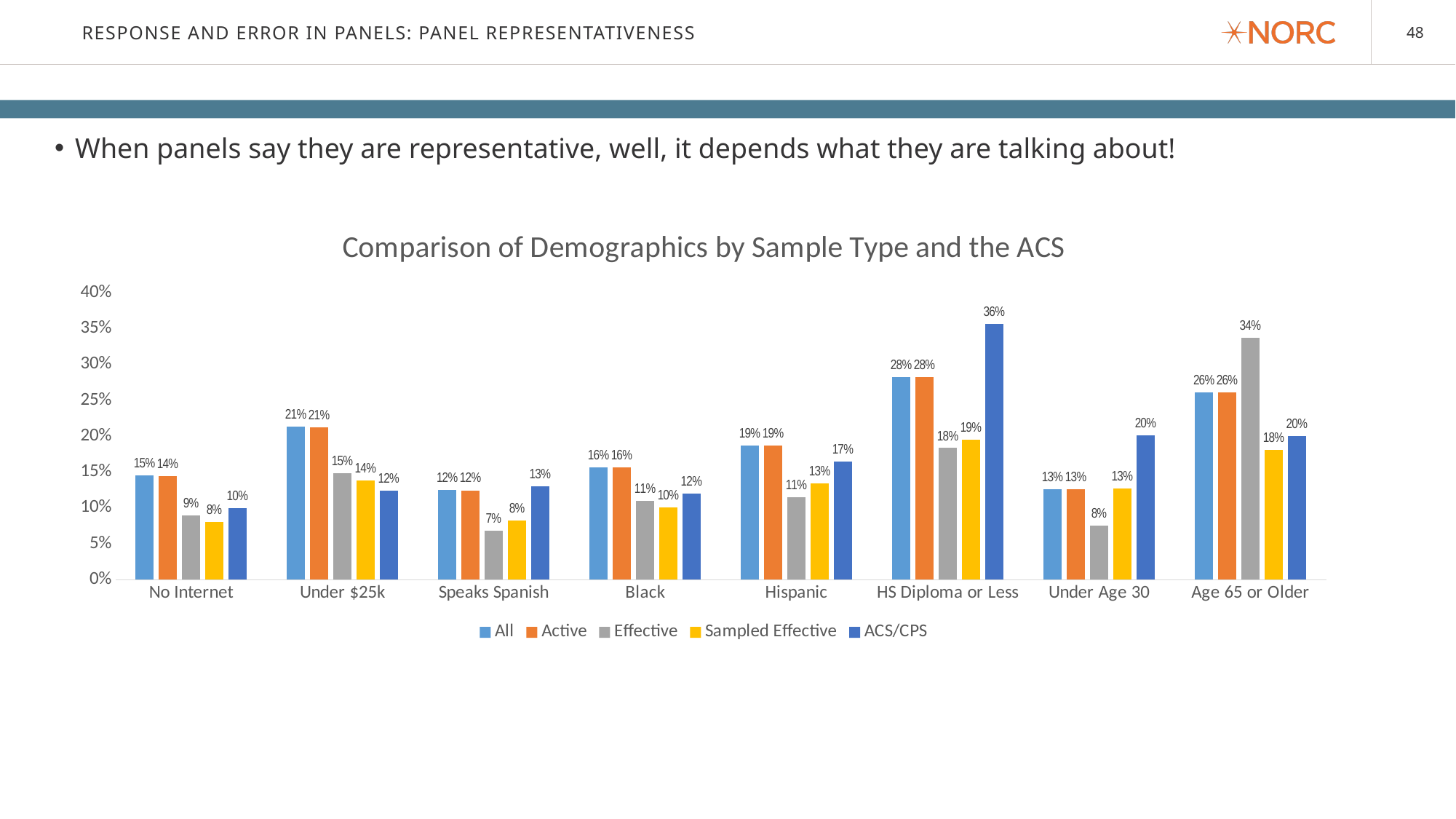
What is the Effective value for Age 65 or Older? 34% How many categories are shown on the x axis? 8 How many series does the legend list? 5 What is the Active value for Hispanic? 19% Which category has the lowest Effective value? Speaks Spanish What is the difference between the ACS/CPS value and the All value for HS Diploma or Less? 8% For Age 65 or Older, which is larger: the Effective value or the ACS/CPS value? Effective What is the title of the chart? Comparison of Demographics by Sample Type and the ACS What kind of chart is shown on the slide? Bar chart What is the Sampled Effective value for Speaks Spanish? 8% What is the ACS/CPS value for HS Diploma or Less? 36% Which category has the highest ACS/CPS value? HS Diploma or Less